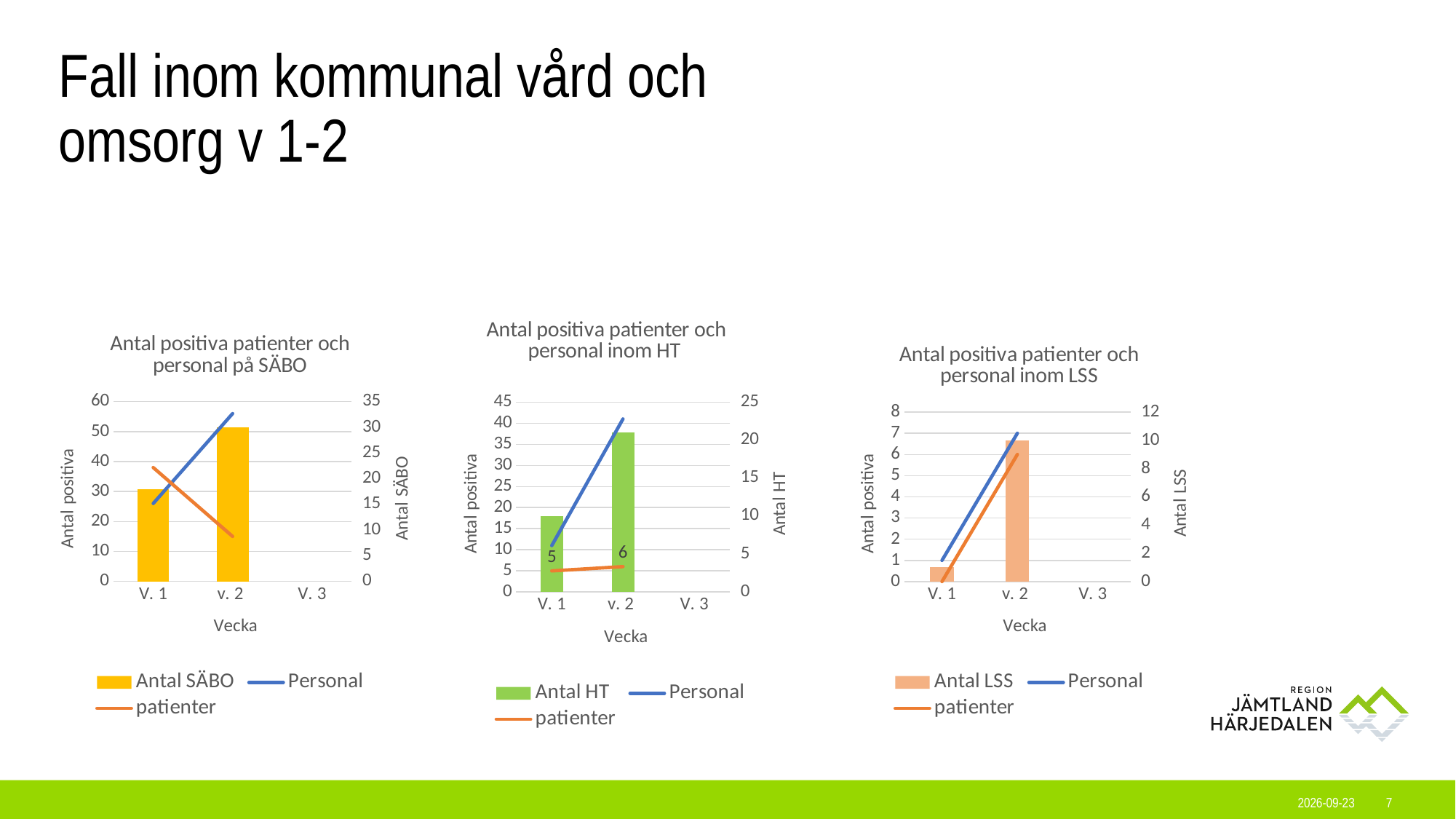
How many series does the legend of the chart 'Antal positiva patienter och personal inom LSS' list? 3 In the chart 'Antal positiva patienter och personal inom HT', by how much does the patienter value increase from V. 1 to v. 2? 1 In the chart 'Antal positiva patienter och personal på SÄBO', does the patienter line rise or fall from V. 1 to v. 2? fall In the chart 'Antal positiva patienter och personal inom HT', what is the patienter value for V. 1? 5 In the chart 'Antal positiva patienter och personal inom HT', which week has the larger patienter value, V. 1 or v. 2? v. 2 How many week categories are shown on the x axis of the chart 'Antal positiva patienter och personal på SÄBO'? 3 In the chart 'Antal positiva patienter och personal inom HT', what is the patienter value for v. 2? 6 In the chart 'Antal positiva patienter och personal på SÄBO', is the Antal SÄBO bar for V. 1 greater or less than 40? less In the chart 'Antal positiva patienter och personal på SÄBO', which week has the highest Antal SÄBO bar? v. 2 In the chart 'Antal positiva patienter och personal inom LSS', does the Personal line rise or fall from V. 1 to v. 2? rise